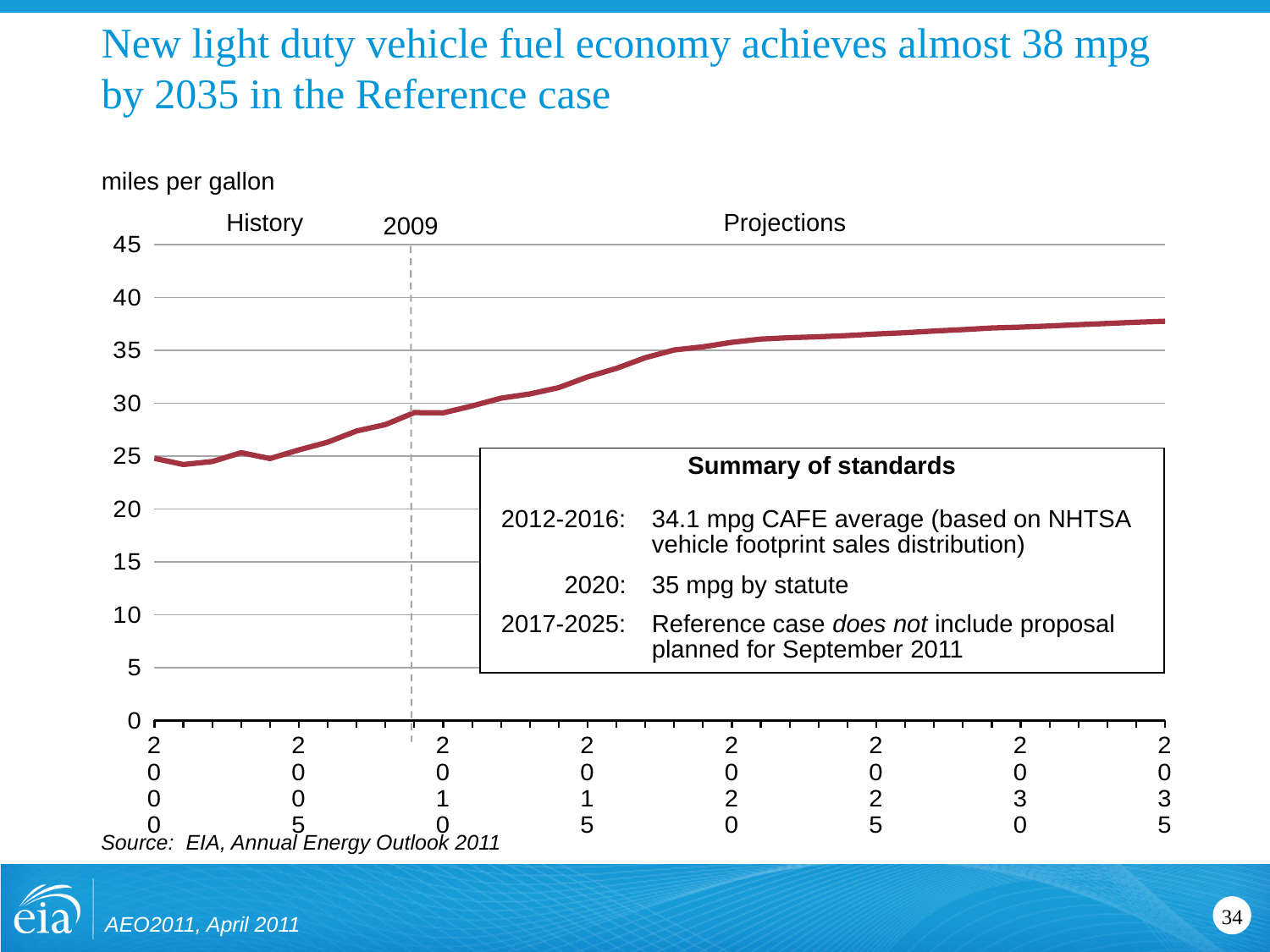
Is the value for 2010 greater or less than 35? less Is the value for 2020 greater or less than 30? greater Is the value for 2000 greater or less than 30? less Do the values on the chart generally rise or fall from 2000 to 2035? rise How many year labels are shown on the x axis? 8 Which year marks the boundary between History and Projections on the chart? 2009 Which labeled year on the x axis has the highest value? 2035 What unit is given for the y axis of the chart? miles per gallon Which is larger, the value for 2000 or the value for 2035? 2035 What kind of chart is shown on the slide? line chart